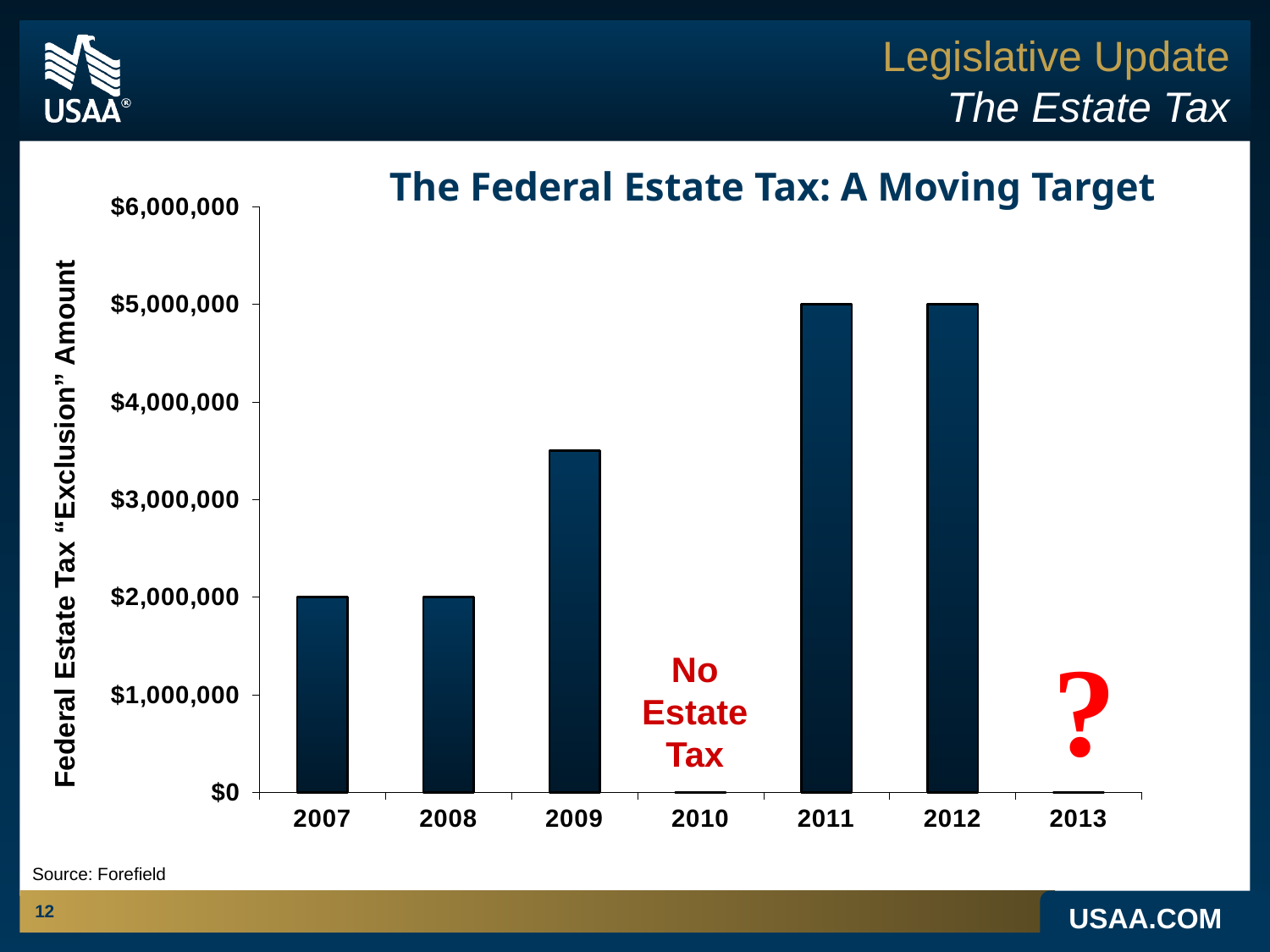
Which year has the larger exclusion amount, 2012 or 2008? 2012 Is the value for 2009 greater or less than $3,000,000? greater What is the difference between the exclusion amounts for 2011 and 2007? $3,000,000 What text is shown in place of a bar for 2010? No Estate Tax Is the value for 2009 greater or less than $4,000,000? less Which year has the larger exclusion amount, 2008 or 2009? 2009 What is the Federal Estate Tax exclusion amount for 2011? $5,000,000 What is the Federal Estate Tax exclusion amount for 2007? $2,000,000 What kind of chart is shown on the slide? bar chart How many years are shown on the x axis of the chart? 7 What is the title of the chart? The Federal Estate Tax: A Moving Target What is the Federal Estate Tax exclusion amount for 2012? $5,000,000